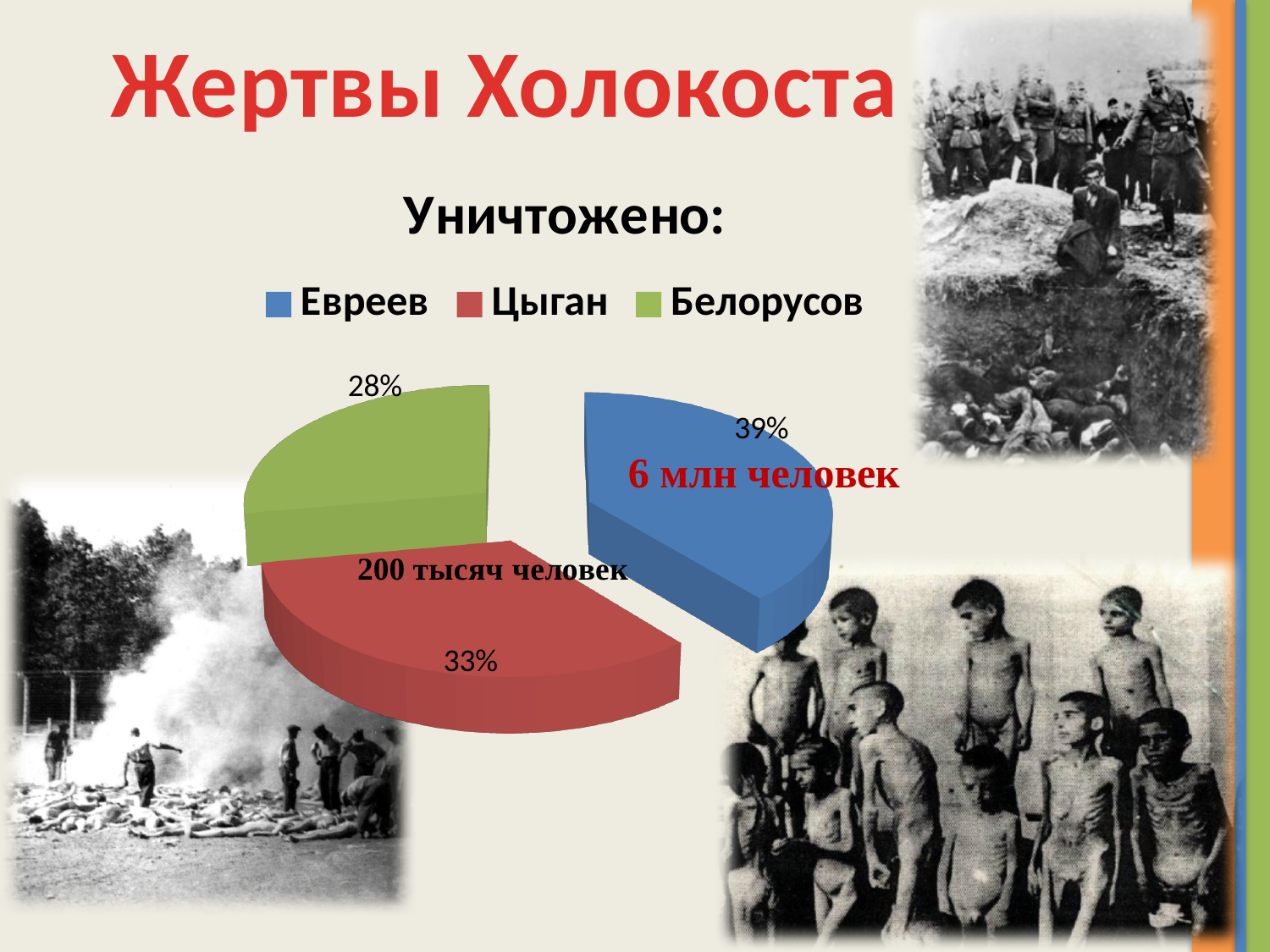
What colour is the Белорусов slice in the chart? green How many slices does the pie chart have? 3 How many entries does the chart legend list? 3 What type of chart is shown on the slide? pie chart What is the difference in percentage points between the Евреев and Белорусов slices? 11 What percentage is shown for the Цыган slice? 33% What percentage is shown for the Белорусов slice? 28% What is the title of the chart? Уничтожено: Which category has the smallest share of the pie? Белорусов Which slice is larger, Цыган or Белорусов? Цыган What percentage is shown for the Евреев slice? 39% Which category has the largest share of the pie? Евреев